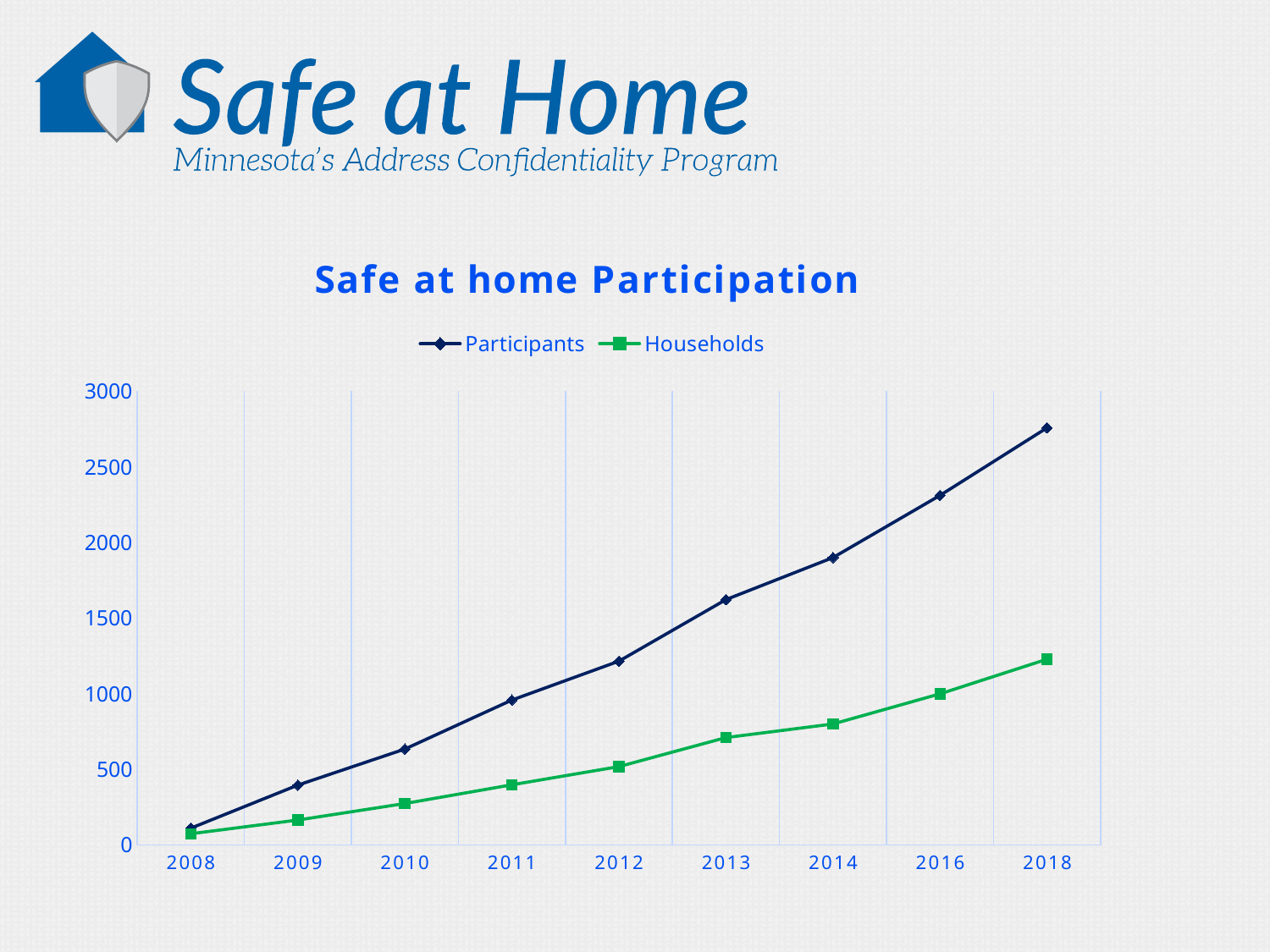
What kind of chart is shown on the slide? line chart What is the title of the chart? Safe at home Participation Is the Participants value for 2018 greater or less than 2500? greater Do the Participants values rise or fall from 2008 to 2018? rise Is the Participants value for 2014 greater or less than 2000? less In which year is the Participants value highest? 2018 Is the Households value for 2018 greater or less than 1000? greater How many years are plotted along the x axis? 9 In which year is the Households value lowest? 2008 How many series does the legend list? 2 In 2018, which is larger, Participants or Households? Participants